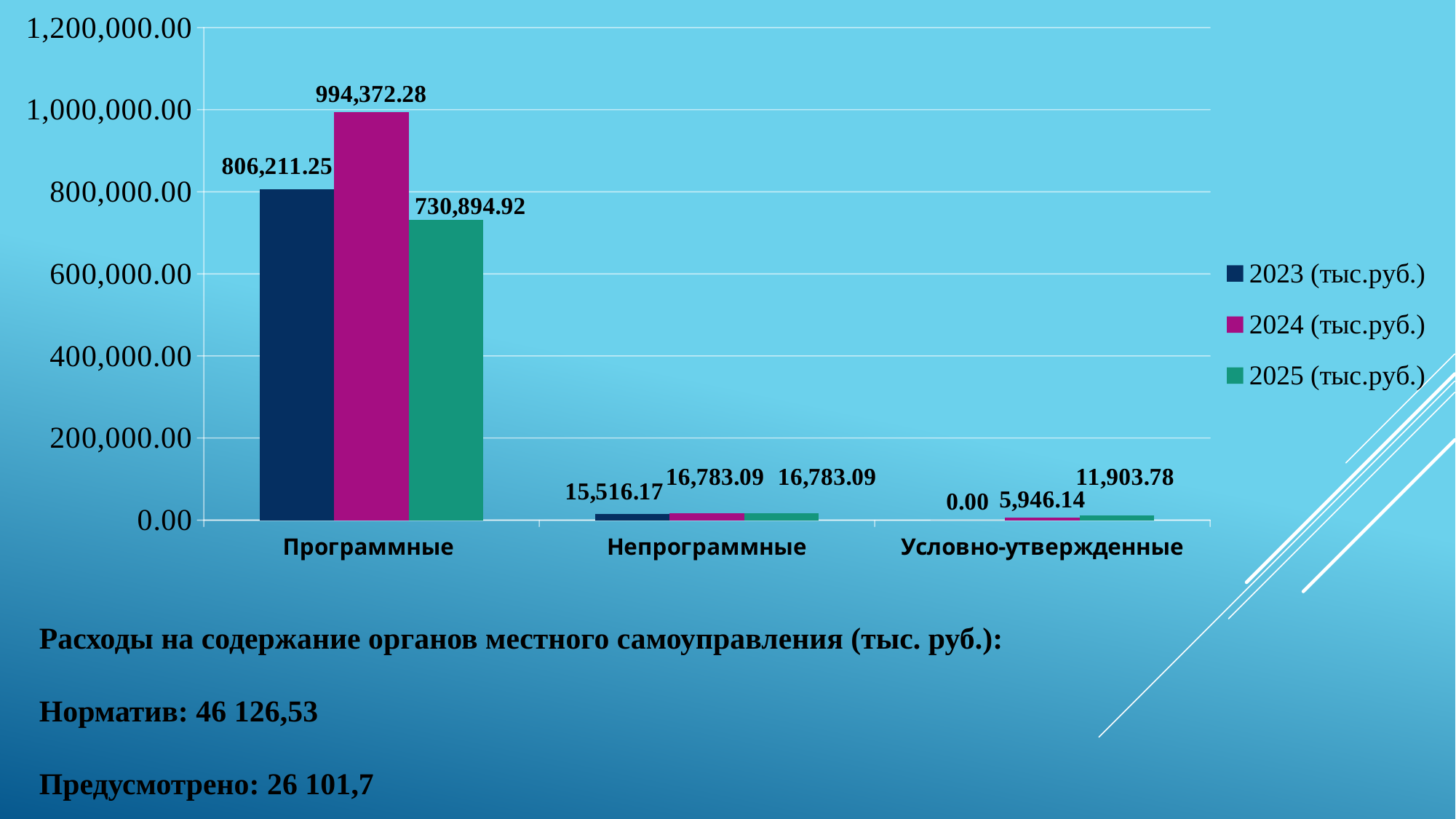
What is the value for Программные in the 2024 (тыс.руб.) series? 994,372.28 What is the difference between the 2025 and 2024 values for Условно-утвержденные? 5,957.64 What is the value for Непрограммные in the 2023 (тыс.руб.) series? 15,516.17 What is the value for Условно-утвержденные in the 2025 (тыс.руб.) series? 11,903.78 What is the difference between the 2024 and 2023 values for Программные? 188,161.03 How many series does the legend list? 3 Which year series has the lowest value for Условно-утвержденные? 2023 (тыс.руб.) Which year series has the highest value for Программные? 2024 (тыс.руб.) Which is larger for Программные: the 2023 value or the 2025 value? 2023 value Is the 2025 value for Программные greater or less than 800,000.00? less How many categories are shown on the x axis? 3 What type of chart is shown on the slide? bar chart